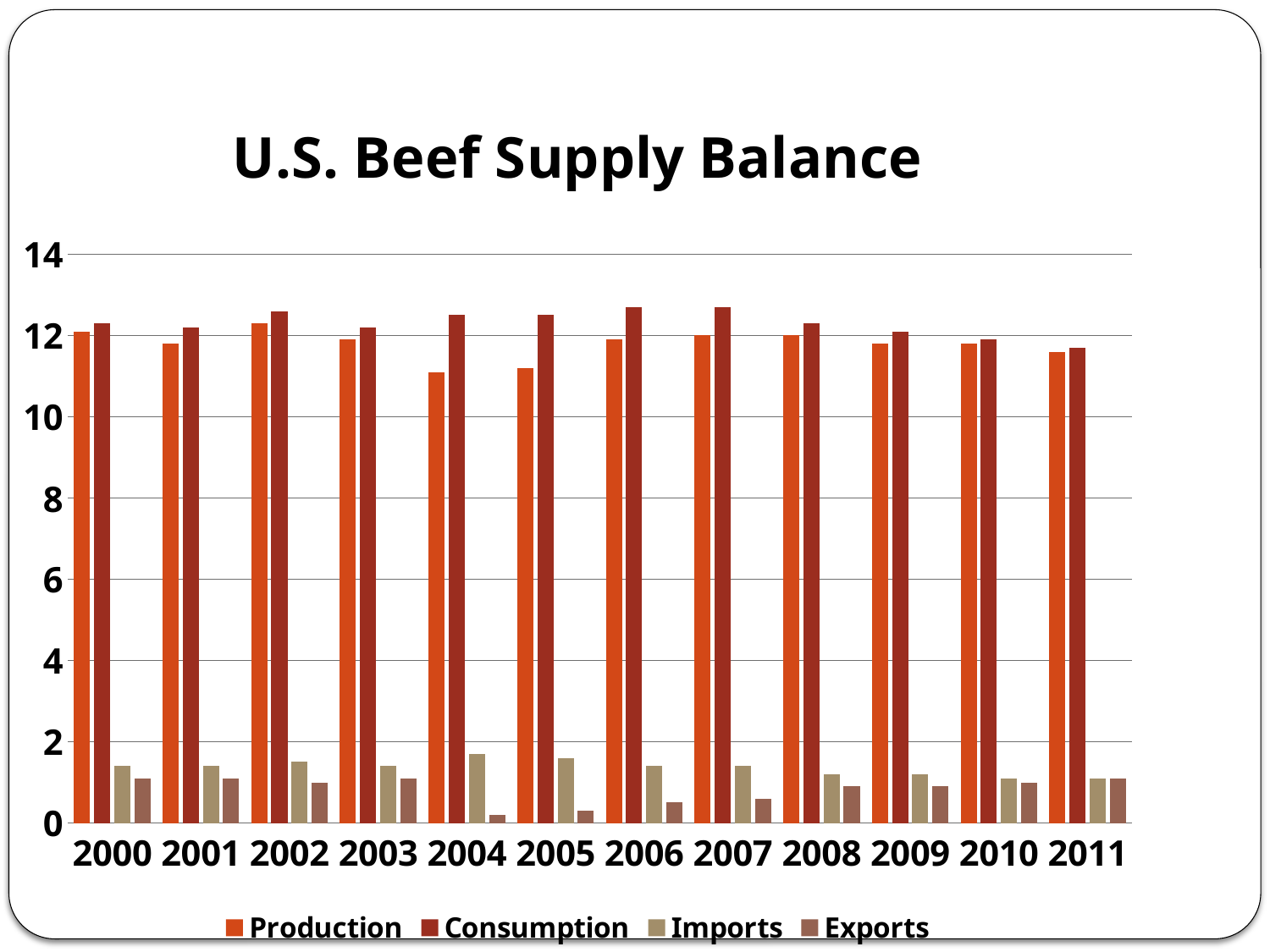
Is the Production value for 2004 greater or less than 10? greater Is the Imports value for 2004 greater or less than 2? less In which year is the Exports value lowest? 2004 How many series does the legend list? 4 Is the Exports value for 2004 greater or less than 1? less What kind of chart is shown on the slide? bar chart Which series is shown in the lightest tan colour? Imports How many years are shown on the x axis? 12 What is the title of the chart? U.S. Beef Supply Balance In 2004, which is larger, Production or Consumption? Consumption Do the Exports values rise or fall from 2004 to 2011? rise